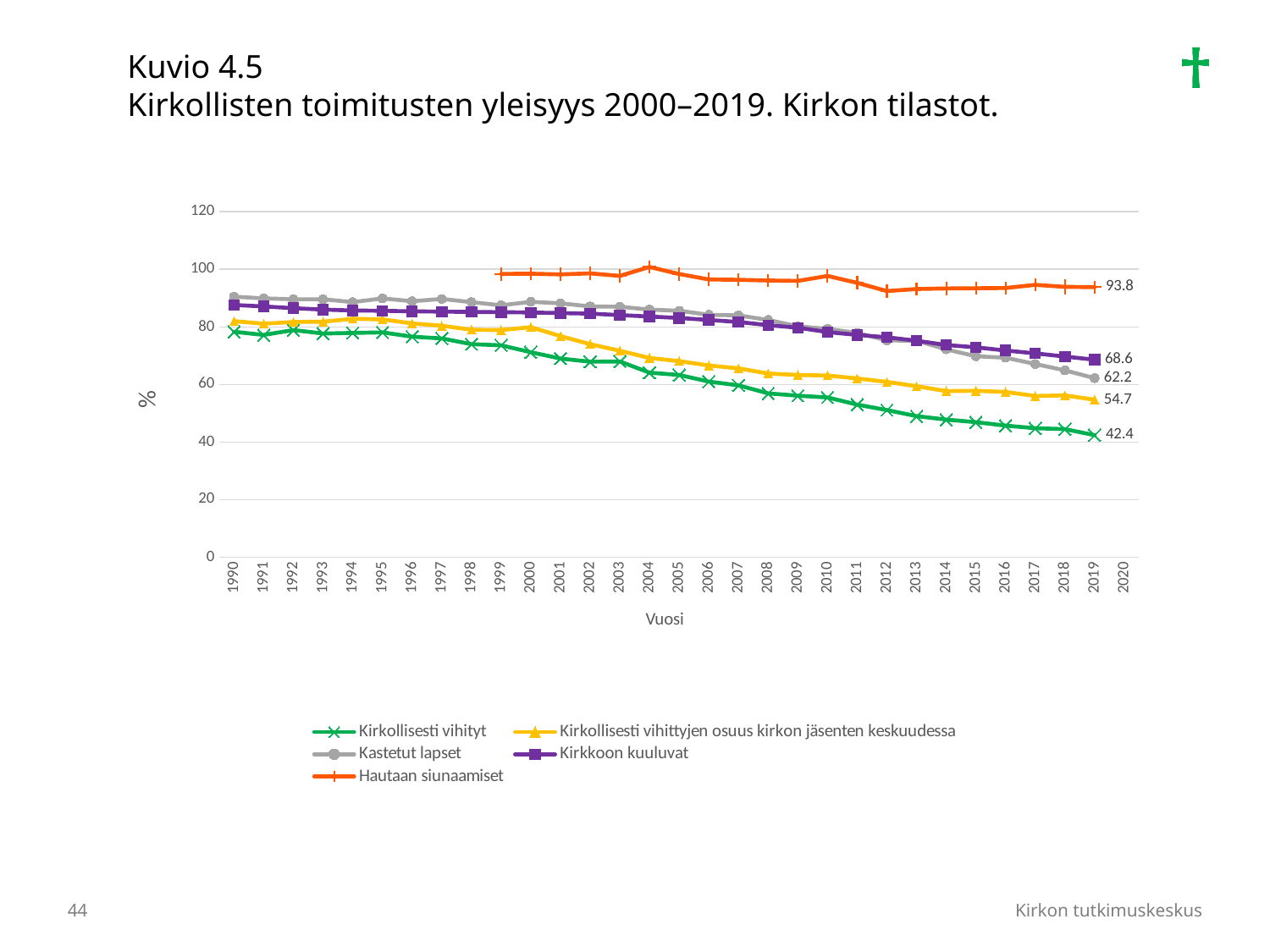
Is the value for Kirkkoon kuuluvat in 1990 greater or less than 80? greater Which series has the lowest value in 2019? Kirkollisesti vihityt Which series has the highest value in 2019? Hautaan siunaamiset What is the value for Kirkkoon kuuluvat in 2019? 68.6 What is the value for Kirkollisesti vihityt in 2019? 42.4 What is the difference between the 2019 values of Kirkkoon kuuluvat and Kastetut lapset? 6.4 What is the value for Hautaan siunaamiset in 2019? 93.8 What kind of chart is shown on the slide? line chart How many series does the legend list? 5 Does the Kirkollisesti vihityt series rise or fall from 1990 to 2019? fall What is the label of the x axis? Vuosi What is the value for Kastetut lapset in 2019? 62.2